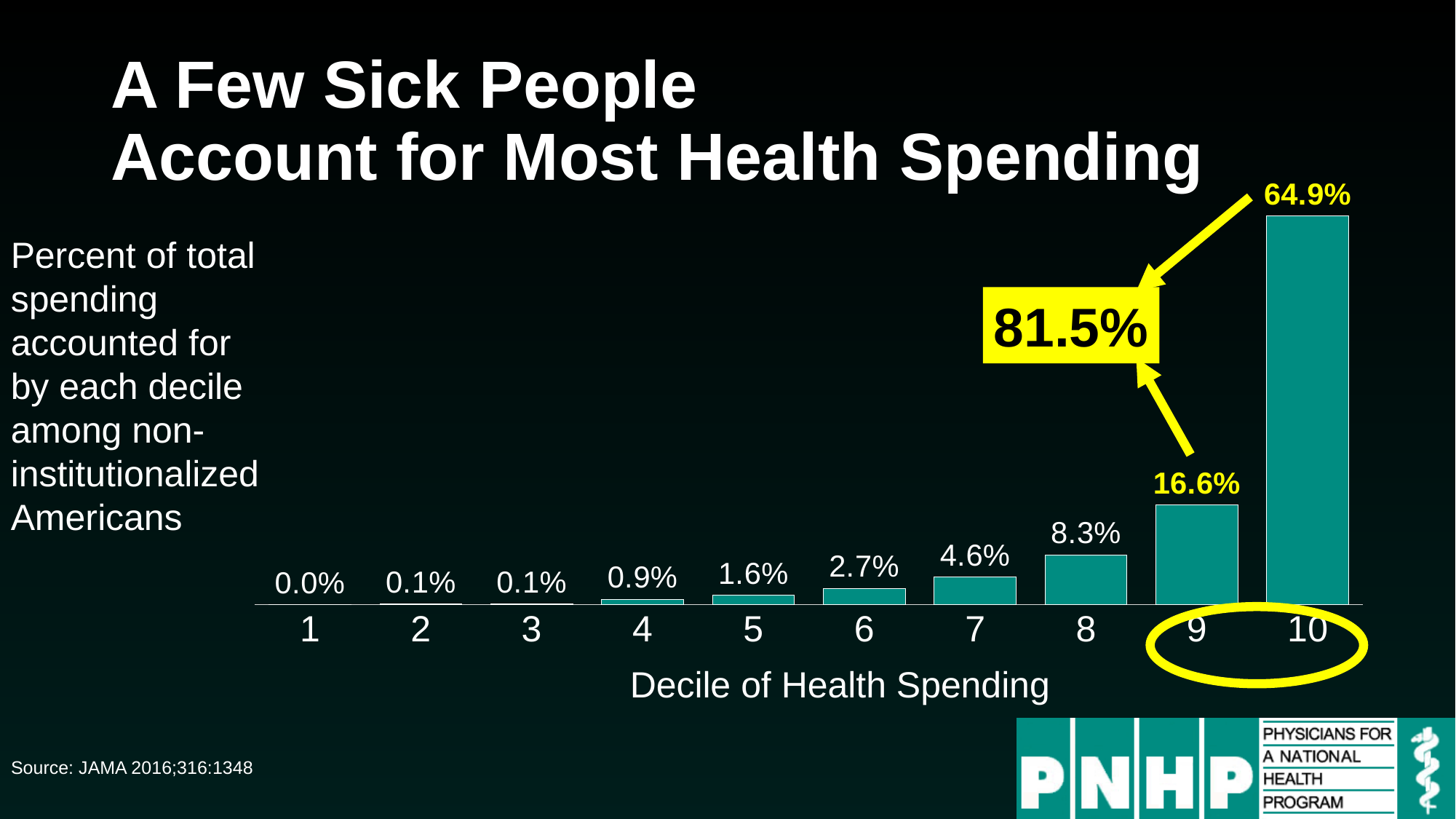
Which decile accounts for the highest share of total spending? 10 Which decile has the lowest value on the chart? 1 What percent of total spending is accounted for by decile 9? 16.6% What combined percentage is highlighted in the yellow box for deciles 9 and 10? 81.5% What is the value shown for decile 8? 8.3% What kind of chart is shown on the slide? bar chart Which is larger, the value for decile 6 or the value for decile 7? decile 7 What is the value shown for decile 5? 1.6% What is the difference between the values for decile 8 and decile 7? 3.7% How many deciles are shown on the x axis? 10 What percent of total spending is accounted for by decile 10? 64.9% What is the difference between the values for decile 10 and decile 9? 48.3%